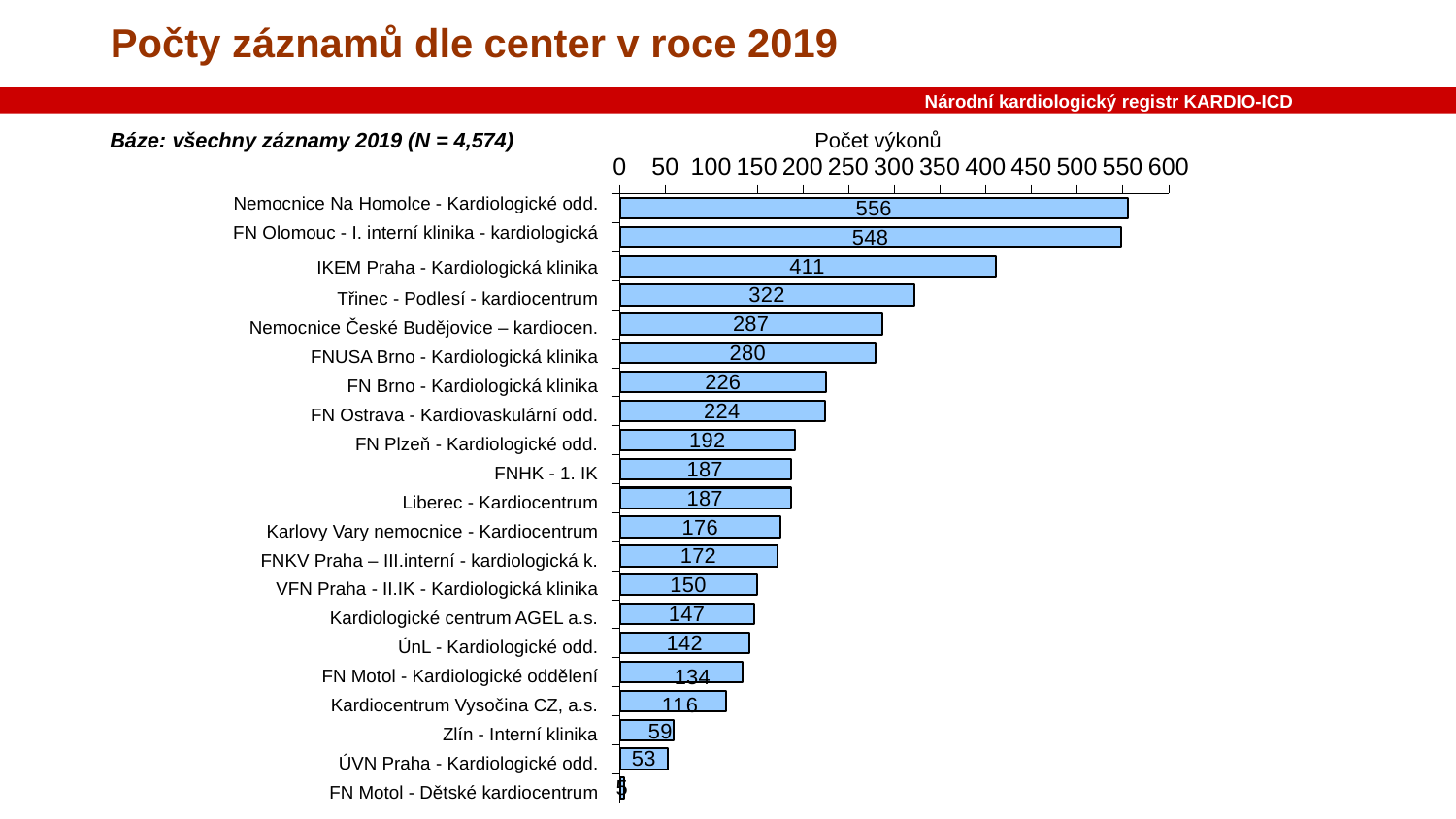
Which center has the highest value? Nemocnice Na Homolce - Kardiologické odd. What is the value for Zlín - Interní klinika? 59 What is the value for FN Plzeň - Kardiologické odd.? 192 What kind of chart is shown on the slide? bar chart Which is larger, the value for FNUSA Brno - Kardiologická klinika or the value for FN Brno - Kardiologická klinika? FNUSA Brno - Kardiologická klinika Which center has the lowest value? FN Motol - Dětské kardiocentrum What is the value for IKEM Praha - Kardiologická klinika? 411 What is the difference between the values for IKEM Praha - Kardiologická klinika and Třinec - Podlesí - kardiocentrum? 89 What is the value for Nemocnice Na Homolce - Kardiologické odd.? 556 What is the title of the chart? Počet výkonů How many centers are shown in the chart? 21 What is the difference between the values for Nemocnice Na Homolce - Kardiologické odd. and FN Olomouc - I. interní klinika - kardiologická? 8